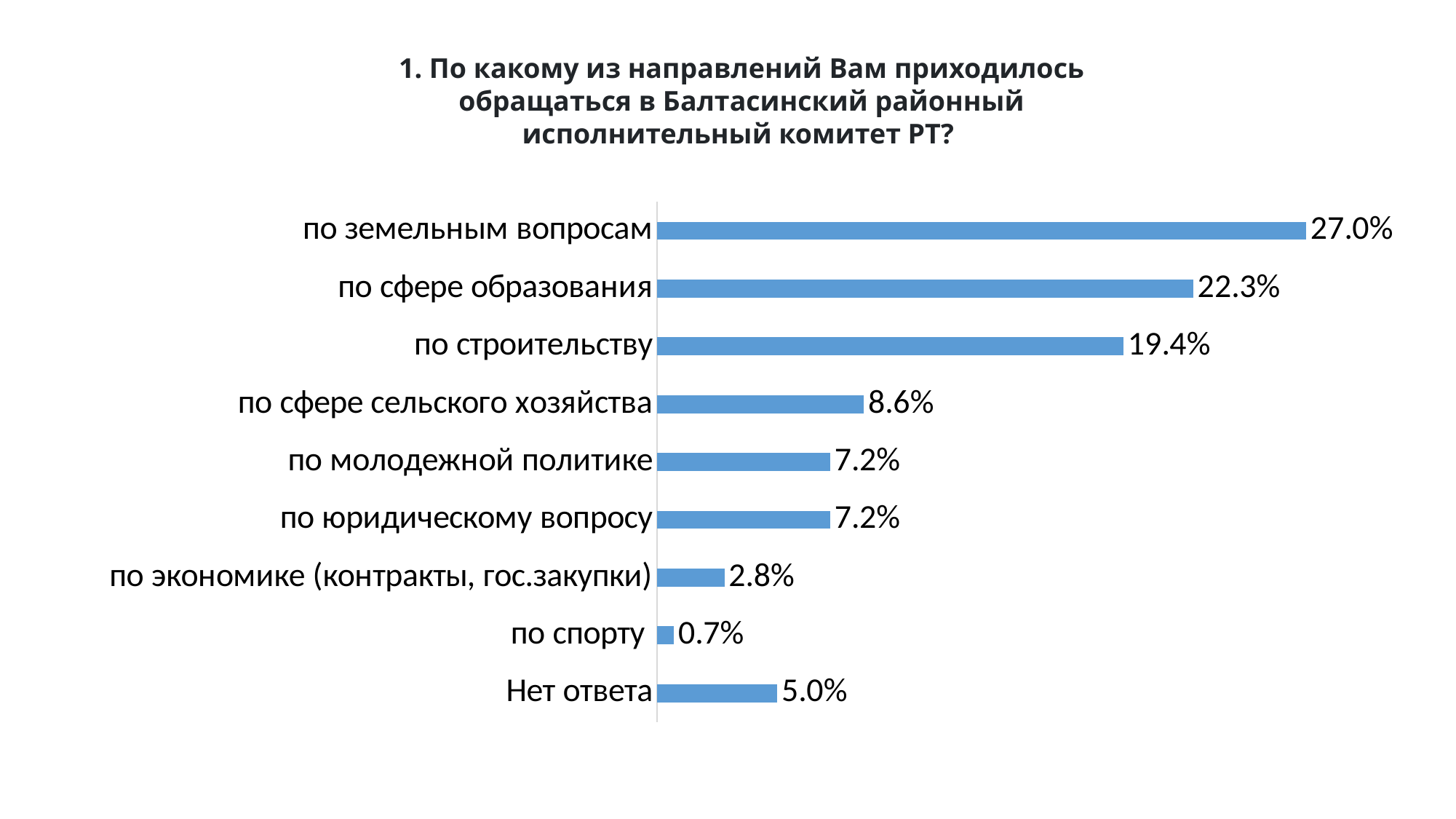
Which is larger, the value for "по сфере образования" or the value for "по строительству"? по сфере образования Which category has the lowest value? по спорту What colour are the bars in the chart? blue What is the difference between the values for "по сфере сельского хозяйства" and "по молодежной политике"? 1.4% What is the difference between the values for "по земельным вопросам" and "по сфере образования"? 4.7% What is the value for "по земельным вопросам"? 27.0% What is the value for "по экономике (контракты, гос.закупки)"? 2.8% What is the value for "по строительству"? 19.4% Which category has the highest value? по земельным вопросам What is the value for "Нет ответа"? 5.0% What kind of chart is shown on the slide? bar chart How many categories are shown in the chart? 9